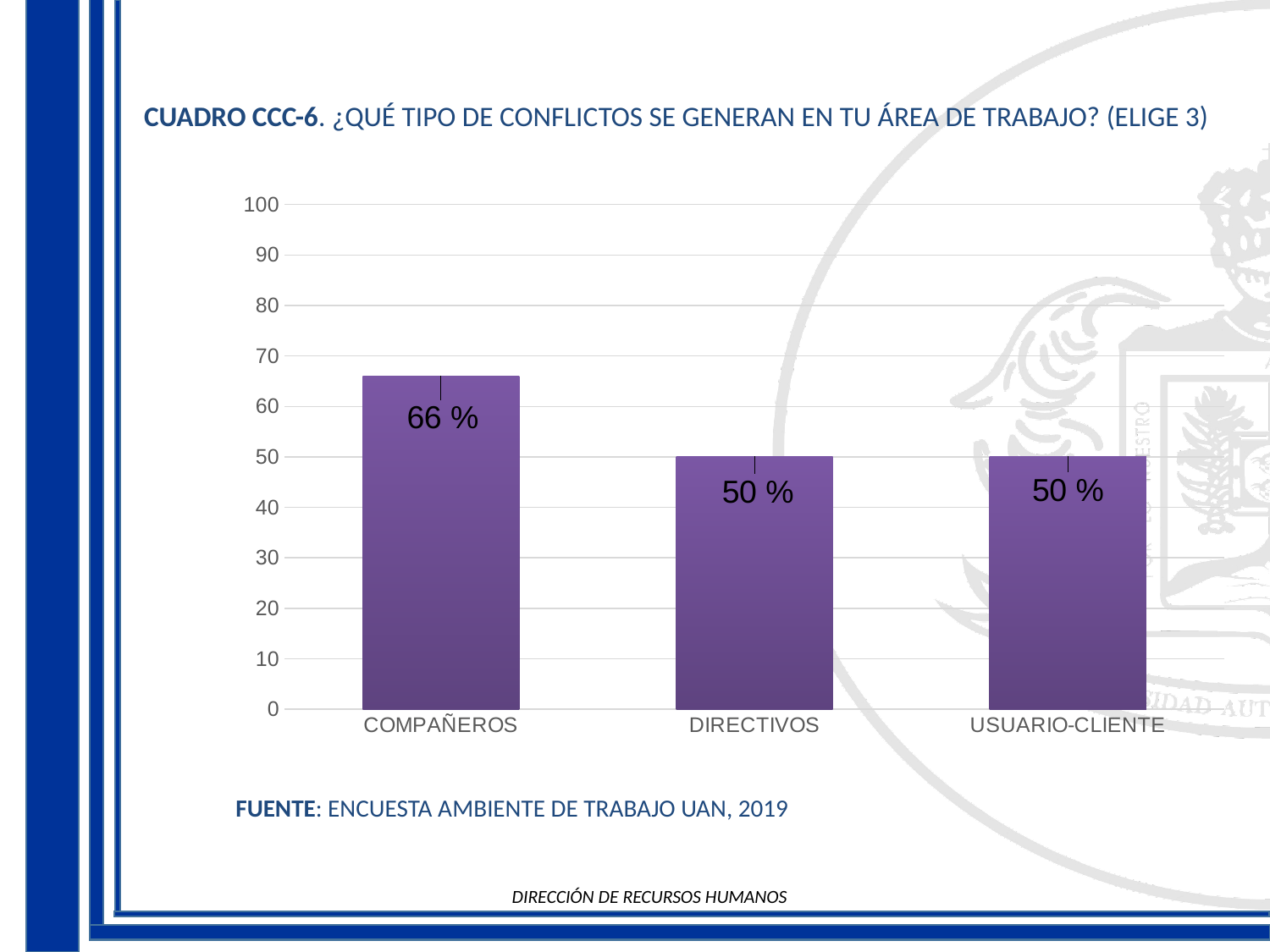
Is the value for DIRECTIVOS greater or less than 70? less What is the value for COMPAÑEROS? 66 % What source is cited below the chart? ENCUESTA AMBIENTE DE TRABAJO UAN, 2019 What is the difference between the values for COMPAÑEROS and DIRECTIVOS? 16 % Which is larger, the value for COMPAÑEROS or the value for USUARIO-CLIENTE? COMPAÑEROS What is the value for DIRECTIVOS? 50 % Which category has the highest value? COMPAÑEROS What kind of chart is shown on the slide? bar chart Is the value for COMPAÑEROS greater or less than 60? greater How many categories are shown on the x axis? 3 What is the value for USUARIO-CLIENTE? 50 % What is the maximum value shown on the y axis? 100